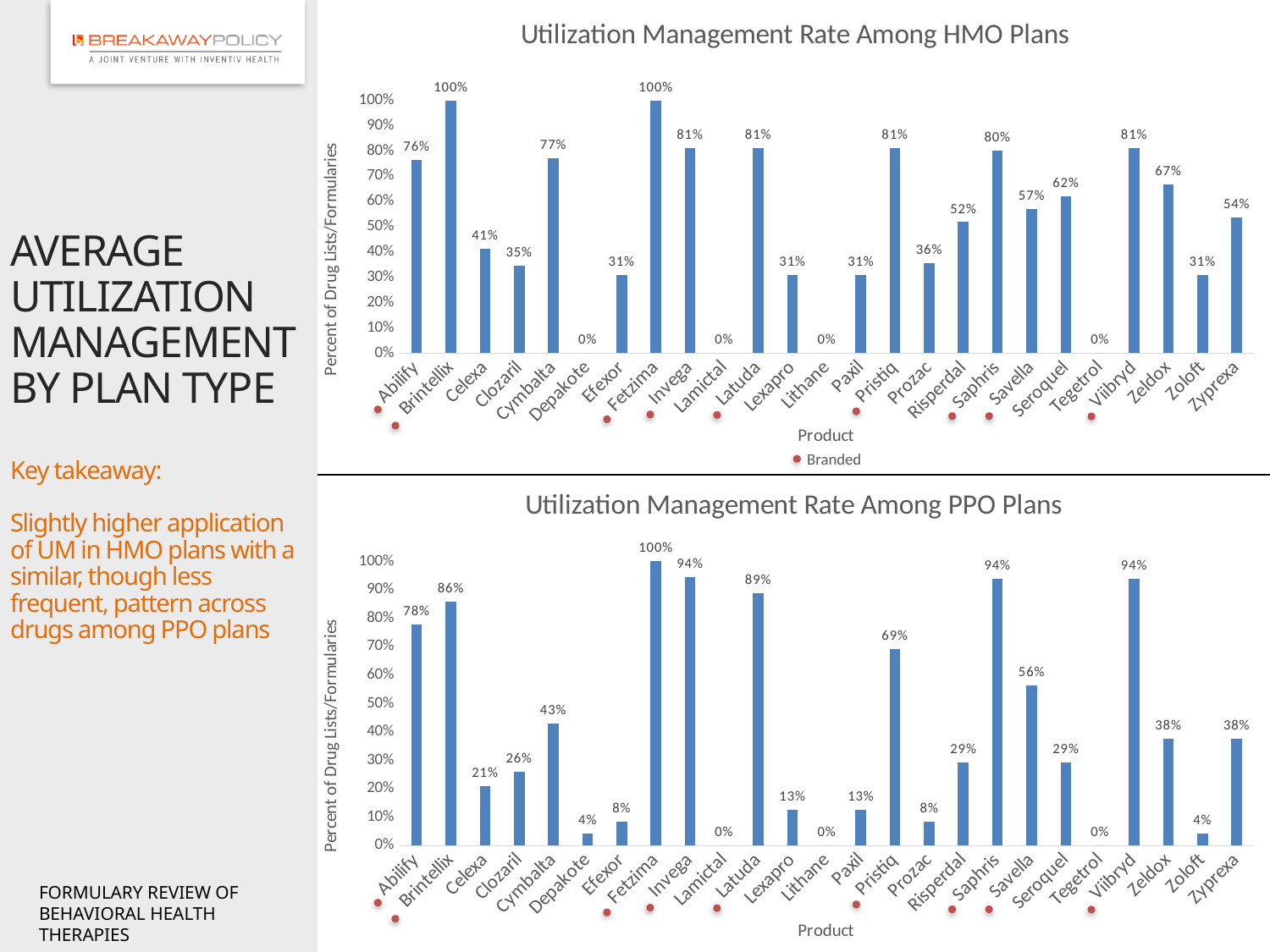
In the Utilization Management Rate Among PPO Plans chart, what is the value for Pristiq? 69% In the Utilization Management Rate Among HMO Plans chart, what is the value for Cymbalta? 77% In the Utilization Management Rate Among PPO Plans chart, what is the value for Zoloft? 4% In the Utilization Management Rate Among PPO Plans chart, what is the value for Saphris? 94% In the Utilization Management Rate Among HMO Plans chart, which is larger, the value for Risperdal or the value for Zyprexa? Zyprexa How many products are shown on the x axis of the Utilization Management Rate Among HMO Plans chart? 25 What kind of chart is the Utilization Management Rate Among PPO Plans chart? Bar chart In the Utilization Management Rate Among PPO Plans chart, which product has the highest value? Fetzima In the Utilization Management Rate Among HMO Plans chart, what is the difference between the values for Seroquel and Savella? 5% In the Utilization Management Rate Among PPO Plans chart, which is larger, the value for Brintellix or the value for Latuda? Latuda What is the y-axis label of the Utilization Management Rate Among HMO Plans chart? Percent of Drug Lists/Formularies In the Utilization Management Rate Among HMO Plans chart, what is the difference between the values for Abilify and Celexa? 35%